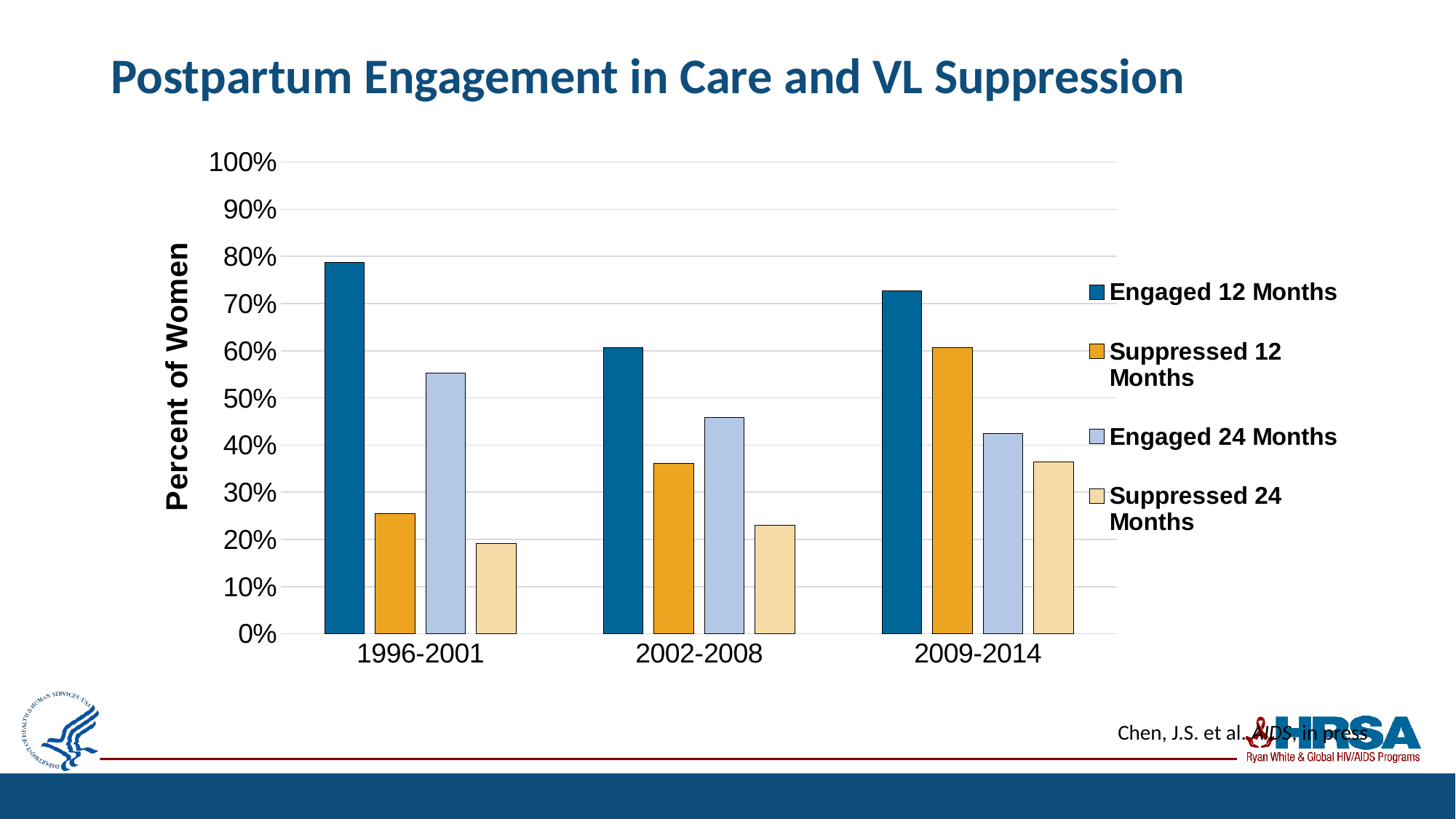
Is the value for Engaged 12 Months in 1996-2001 greater or less than 70%? greater In which period is the Suppressed 24 Months value lowest? 1996-2001 What is the label on the vertical axis? Percent of Women In which period is the Engaged 12 Months value highest? 1996-2001 Is the value for Engaged 24 Months in 2002-2008 greater or less than 50%? less In 2009-2014, which is larger: Engaged 12 Months or Suppressed 12 Months? Engaged 12 Months Is the value for Suppressed 12 Months in 1996-2001 greater or less than 30%? less How many time periods are shown on the x axis? 3 How many series does the legend list? 4 Does the Suppressed 12 Months value rise or fall across the periods from 1996-2001 to 2009-2014? Rise What kind of chart is shown on the slide? Bar chart